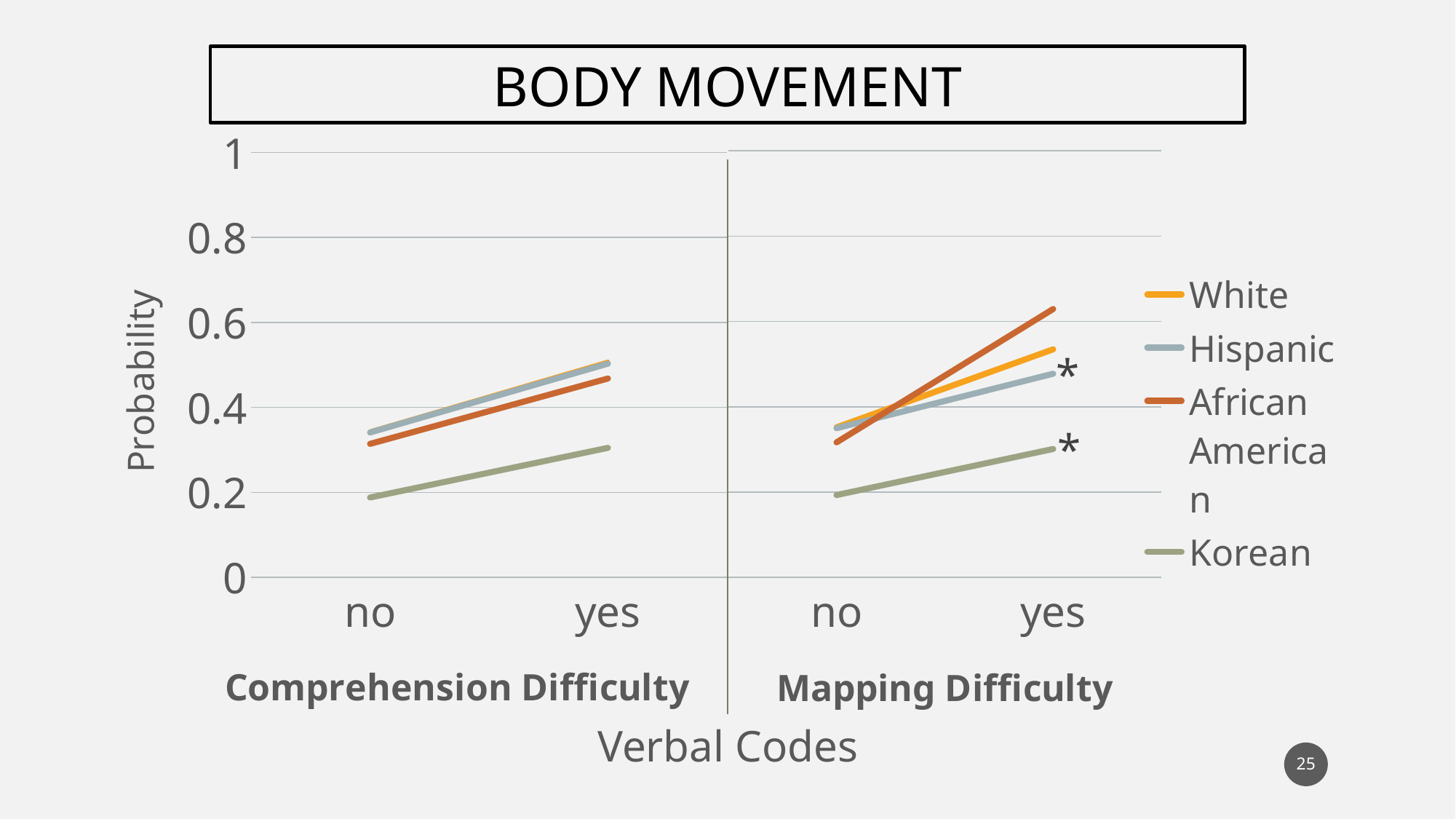
At 'yes' under Mapping Difficulty, which is larger: the value for African American or the value for Korean? African American How many verbal code groups are shown along the x axis? 2 Is the value for Korean at 'yes' under Comprehension Difficulty greater or less than 0.4? less Does the Korean line rise or fall from 'no' to 'yes' under Comprehension Difficulty? rise Is the value for White at 'yes' under Mapping Difficulty greater or less than 0.4? greater Does the African American line rise or fall from 'no' to 'yes' under Mapping Difficulty? rise What is the label of the y axis? Probability How many series does the legend list? 4 What kind of chart is shown on the slide? line chart Which series has the lowest value at 'yes' under Mapping Difficulty? Korean Which series has the lowest value at 'no' under Comprehension Difficulty? Korean Which series has the highest value at 'yes' under Mapping Difficulty? African American